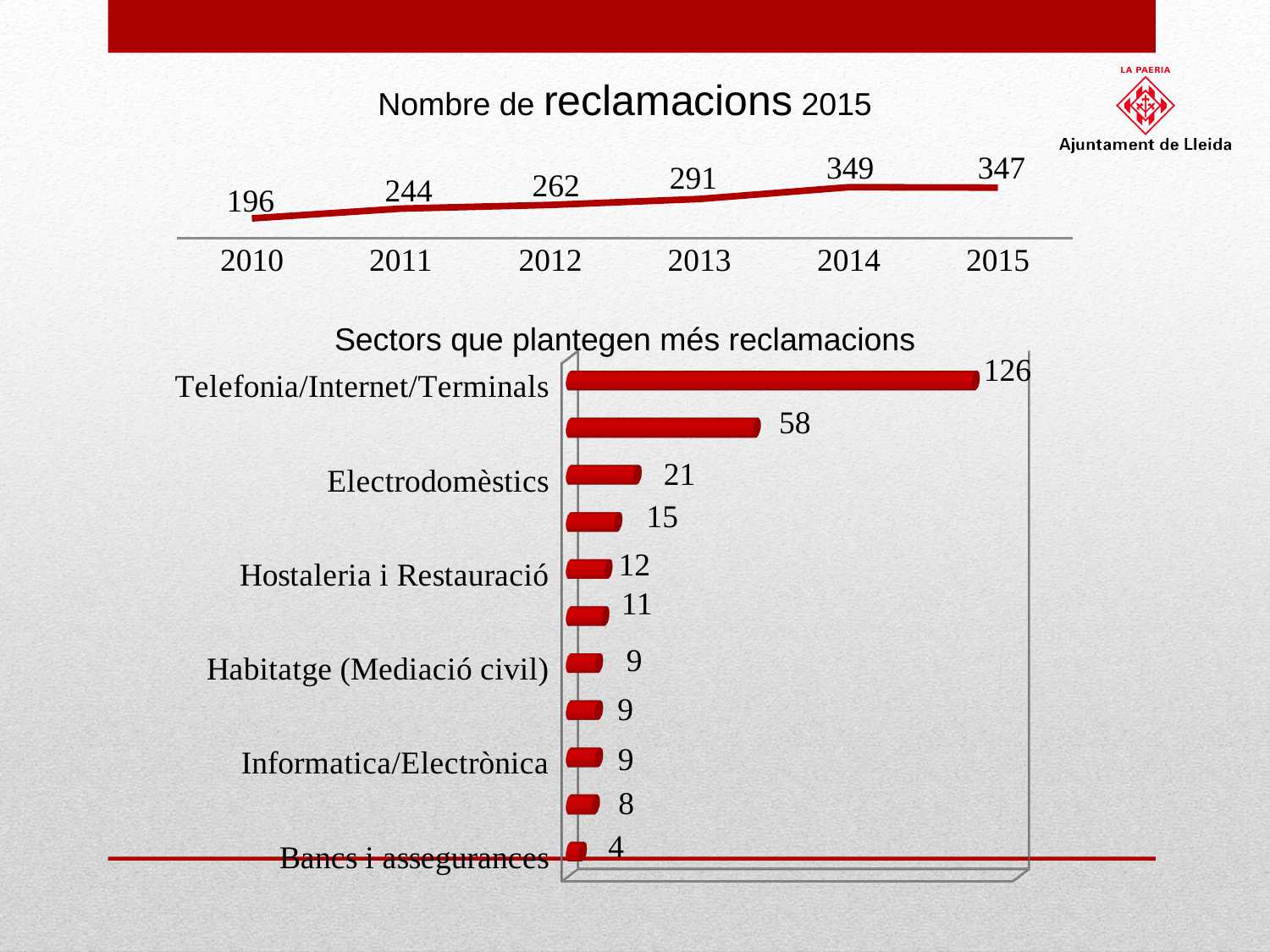
In the line chart 'Nombre de reclamacions 2015', what is the difference between the values for 2013 and 2012? 29 What kind of chart is 'Sectors que plantegen més reclamacions'? bar chart In the bar chart 'Sectors que plantegen més reclamacions', what is the value for Electrodomèstics? 21 In the line chart 'Nombre de reclamacions 2015', how many years are plotted? 6 In the line chart 'Nombre de reclamacions 2015', which year has the highest value? 2014 In the line chart 'Nombre de reclamacions 2015', which year has the lowest value? 2010 In the line chart 'Nombre de reclamacions 2015', what is the value for 2010? 196 In the bar chart 'Sectors que plantegen més reclamacions', what is the value for Telefonia/Internet/Terminals? 126 In the bar chart 'Sectors que plantegen més reclamacions', which is larger: Hostaleria i Restauració or Informatica/Electrònica? Hostaleria i Restauració In the line chart 'Nombre de reclamacions 2015', what is the value for 2014? 349 In the bar chart 'Sectors que plantegen més reclamacions', which sector has the lowest value? Bancs i assegurances In the line chart 'Nombre de reclamacions 2015', do the values generally rise or fall from 2010 to 2014? rise